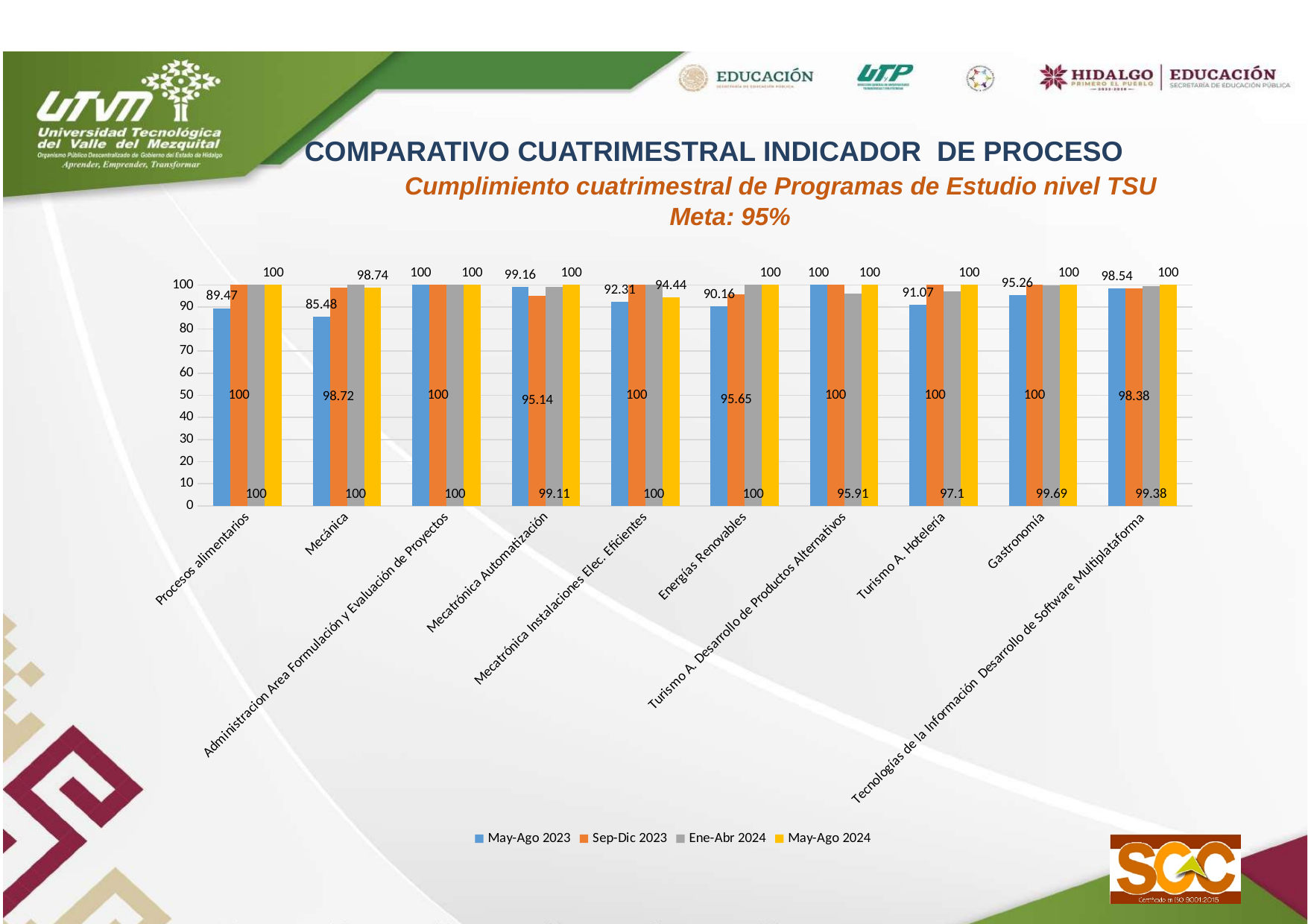
What is the May-Ago 2023 value for Procesos alimentarios? 89.47 What target (Meta) is stated above the chart? 95% What is the May-Ago 2023 value for Mecánica? 85.48 What kind of chart is shown on the slide? bar chart What is the May-Ago 2024 value for Mecatrónica Instalaciones Elec. Eficientes? 94.44 How many program categories are shown along the x axis? 10 What is the difference between the May-Ago 2023 values for Procesos alimentarios and Mecánica? 3.99 What is the May-Ago 2024 value for Mecánica? 98.74 Is the May-Ago 2023 value for Mecánica greater or less than 90? less What is the May-Ago 2023 value for Gastronomía? 95.26 How many series does the legend list? 4 Which category has the lowest May-Ago 2023 value? Mecánica